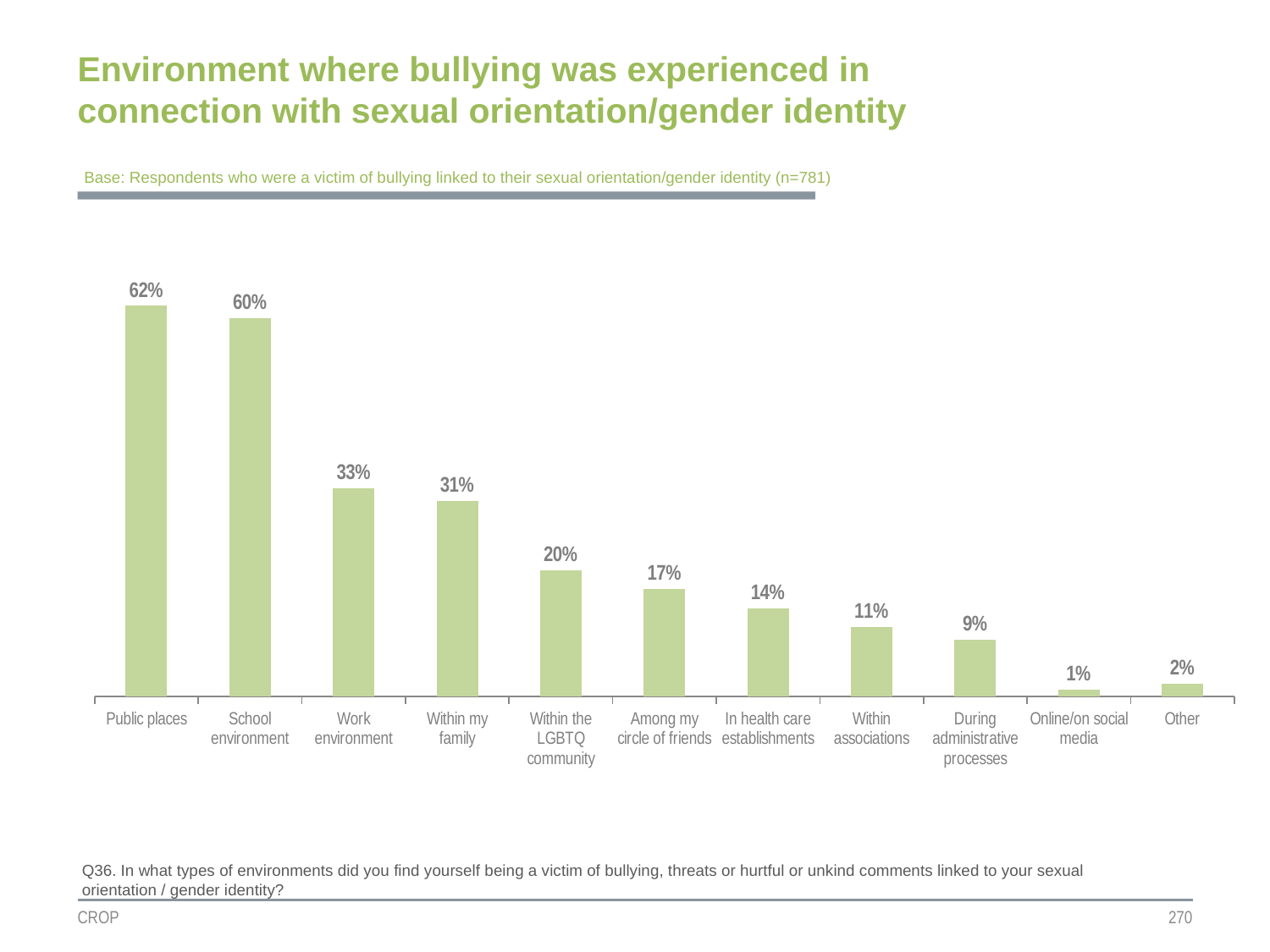
What is the base size (n) stated for the chart? n=781 What percentage is shown for 'Within the LGBTQ community'? 20% How many environment categories are shown on the chart? 11 What is the value for the school environment? 60% What is the value for 'Online/on social media'? 1% What is the difference between the work environment and 'Within my family' values? 2% What is the difference between the public places value and the 'Among my circle of friends' value? 45% What percentage of respondents experienced bullying in public places? 62% Which environment has the lowest percentage? Online/on social media Which environment has the highest percentage? Public places What type of chart is shown on the slide? Bar chart Which is larger: the value for 'In health care establishments' or the value for 'Within associations'? In health care establishments